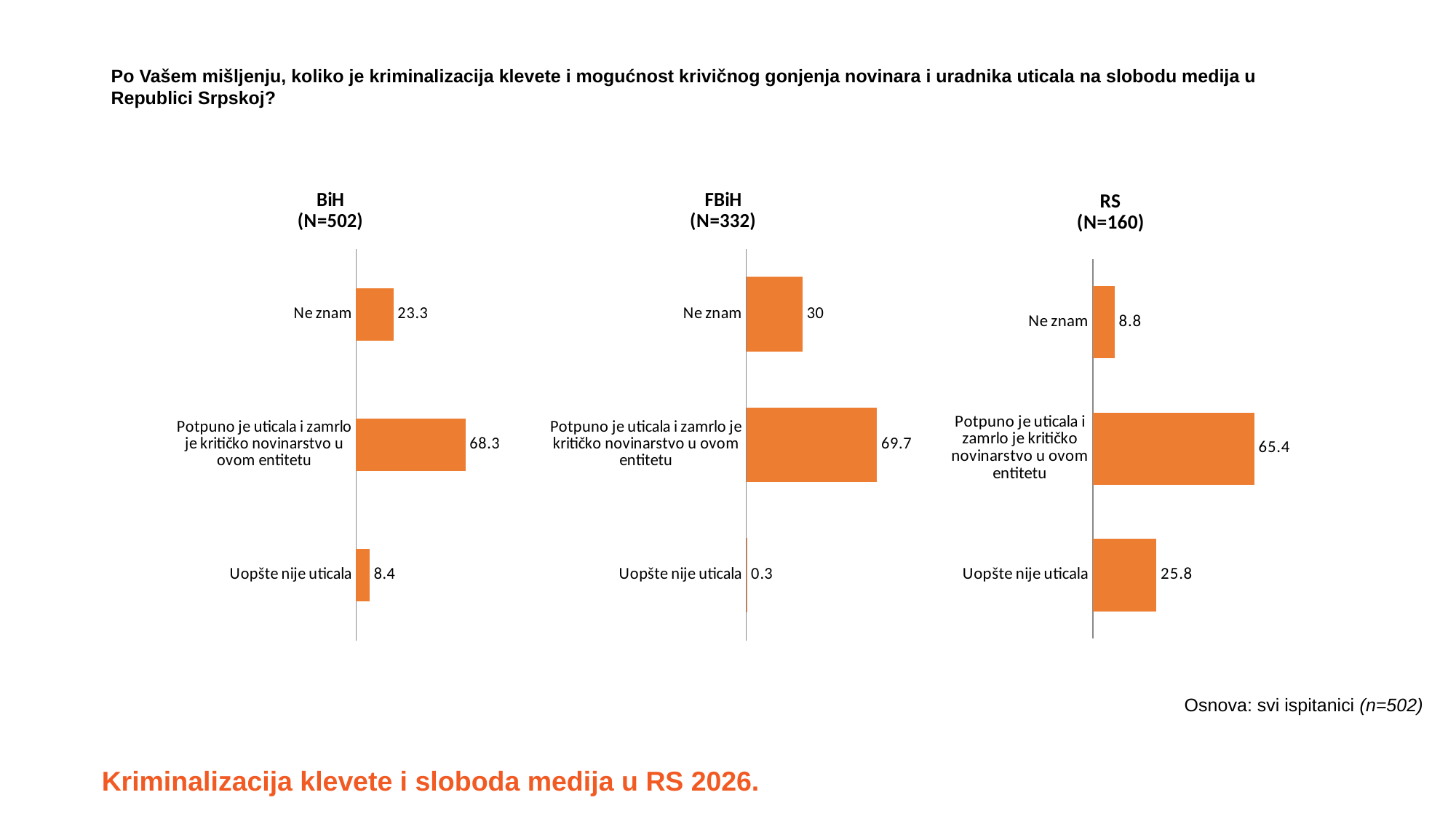
In the RS (N=160) chart, what is the value for "Potpuno je uticala i zamrlo je kritičko novinarstvo u ovom entitetu"? 65.4 In the RS (N=160) chart, what is the difference between "Uopšte nije uticala" and "Ne znam"? 17 What kind of chart is the FBiH (N=332) chart? Bar chart What colour are the bars in the RS (N=160) chart? Orange In the BiH (N=502) chart, which category has the lowest value? Uopšte nije uticala In the BiH (N=502) chart, what is the value for "Ne znam"? 23.3 How many categories does the BiH (N=502) chart show? 3 In the FBiH (N=332) chart, what is the value for "Uopšte nije uticala"? 0.3 How many charts are shown on the slide? 3 In the FBiH (N=332) chart, what is the difference between "Potpuno je uticala i zamrlo je kritičko novinarstvo u ovom entitetu" and "Ne znam"? 39.7 Which is larger: "Ne znam" in the FBiH (N=332) chart or "Ne znam" in the RS (N=160) chart? FBiH (N=332) In the RS (N=160) chart, which category has the highest value? Potpuno je uticala i zamrlo je kritičko novinarstvo u ovom entitetu